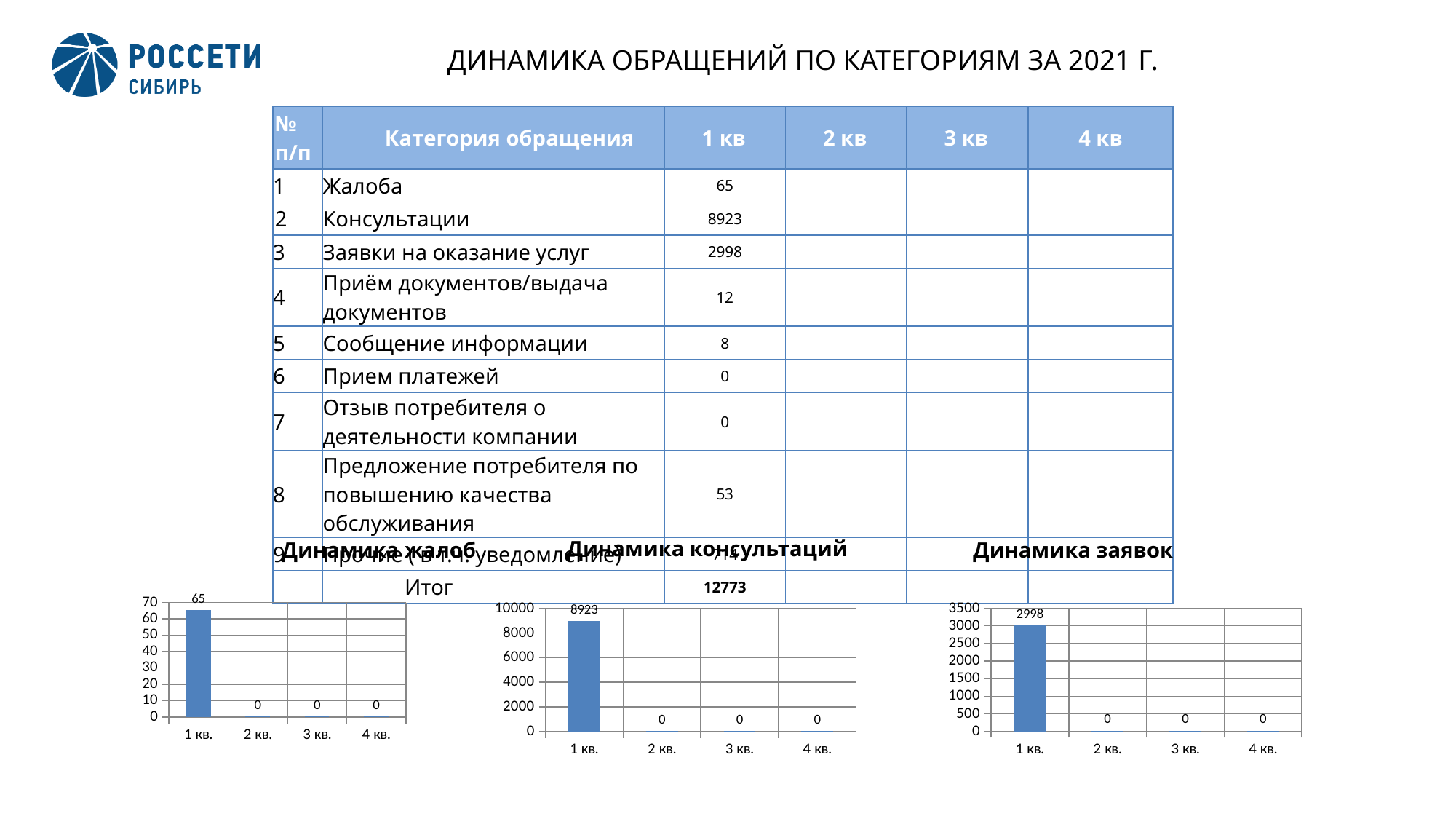
In the 'Динамика жалоб' chart, what is the value for 3 кв.? 0 In the 'Динамика жалоб' chart, do the values rise or fall from 1 кв. to 4 кв.? fall What type of chart is the 'Динамика жалоб' chart? bar chart In the 'Динамика заявок' chart, which quarter has the highest value? 1 кв. In the 'Динамика консультаций' chart, what is the difference between the values for 1 кв. and 2 кв.? 8923 In the 'Динамика консультаций' chart, how many categories are shown on the x axis? 4 What is the title of the chart on the right of the slide? Динамика заявок In the 'Динамика консультаций' chart, what is the value for 1 кв.? 8923 In the 'Динамика жалоб' chart, what is the value for 1 кв.? 65 In the 'Динамика заявок' chart, what is the value for 1 кв.? 2998 In the 'Динамика консультаций' chart, which is larger, the value for 1 кв. or the value for 4 кв.? 1 кв. In the 'Динамика заявок' chart, is the value for 1 кв. greater or less than 2500? greater